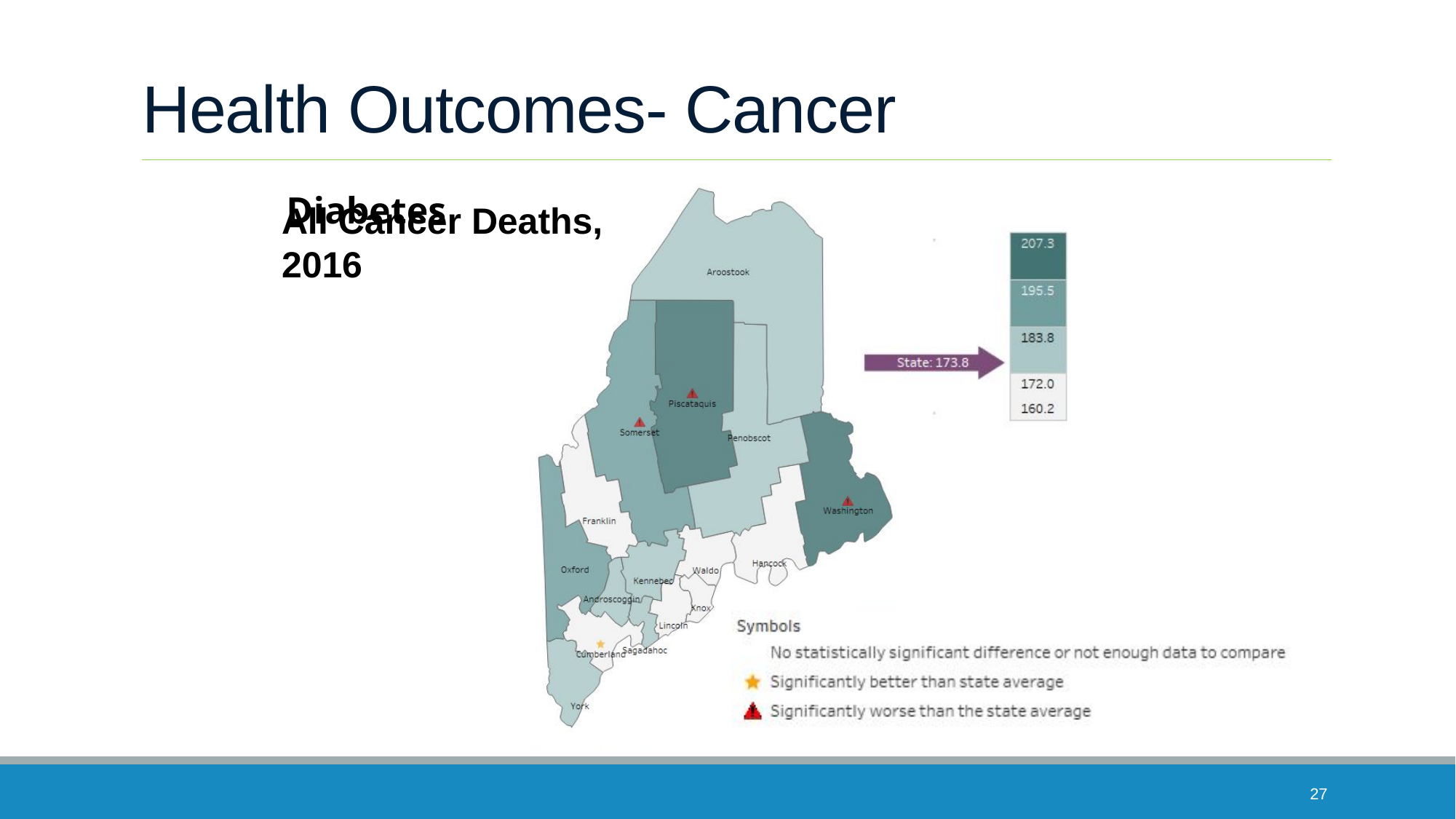
Which county is marked with a star as significantly better than the state average? Cumberland How many counties are marked as significantly worse than the state average? 3 What is the state value shown by the arrow on the map legend? 173.8 Which counties are marked with a red triangle as significantly worse than the state average? Piscataquis, Somerset, Washington What is the difference between the highest and lowest values on the colour legend? 47.1 What kind of chart is shown on the slide? Map (choropleth map of Maine counties) What is the title of the map? All Cancer Deaths, 2016 Is the value for Washington county greater or less than 183.8? greater What is the lowest value shown on the map's colour legend? 160.2 How many counties are labelled on the map? 16 What does the red triangle symbol mean on the map? Significantly worse than the state average What is the highest value shown on the map's colour legend? 207.3